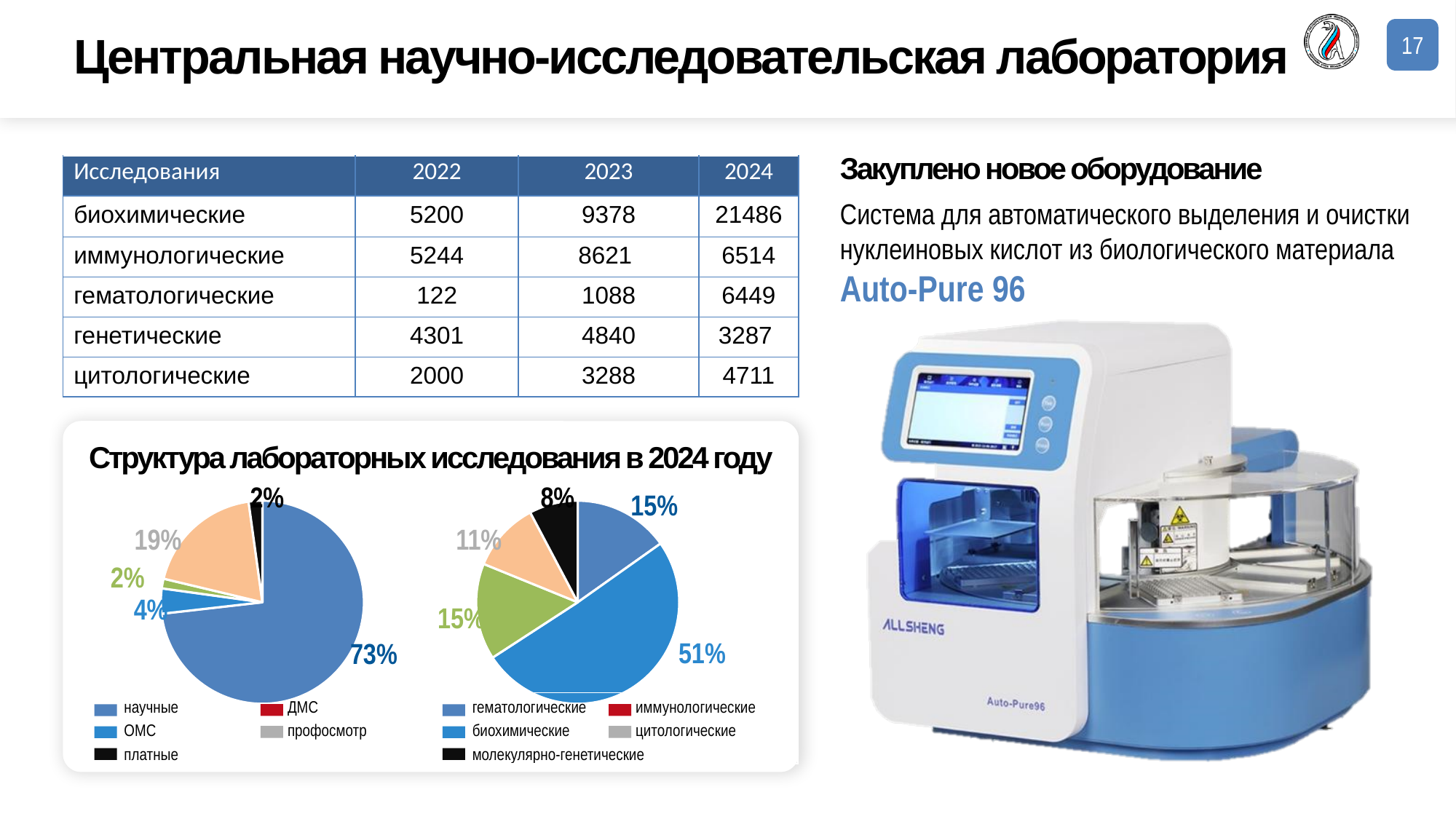
In the left pie chart, what share is shown for ОМС? 4% In the left pie chart, what share is shown for научные? 73% In the right pie chart, which category has the largest slice? биохимические In the right pie chart, which category has the smallest slice? молекулярно-генетические In the right pie chart, what share is shown for молекулярно-генетические? 8% What is the title shown above the two pie charts? Структура лабораторных исследования в 2024 году In the right pie chart, how many percentage points larger is биохимические than гематологические? 36 What kind of chart is used in the left chart under "Структура лабораторных исследования в 2024 году"? pie chart In the right pie chart, what share is shown for гематологические? 15% In the right pie chart, what share is shown for биохимические? 51% In the left pie chart, which category has the largest slice? научные How many categories does the legend of the left pie chart list? 5